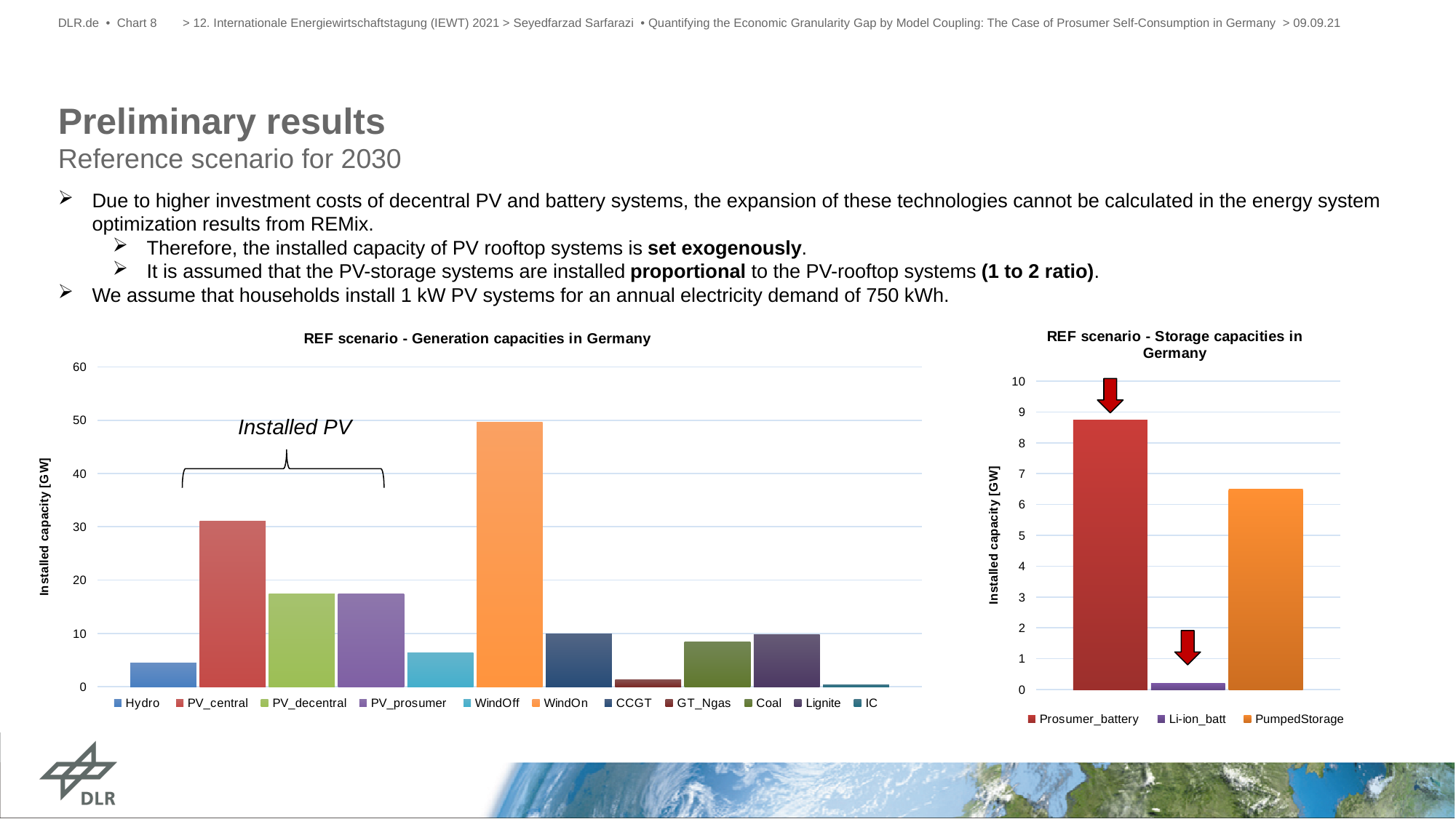
In the 'REF scenario - Storage capacities in Germany' chart, which category has the lowest installed capacity? Li-ion_batt In the 'REF scenario - Storage capacities in Germany' chart, which category has the highest installed capacity? Prosumer_battery What is the y-axis label of the 'REF scenario - Storage capacities in Germany' chart? Installed capacity [GW] How many series does the legend of the 'REF scenario - Storage capacities in Germany' chart list? 3 What kind of chart is the 'REF scenario - Generation capacities in Germany' chart? bar chart In the 'REF scenario - Generation capacities in Germany' chart, is the value for PV_central greater or less than 20? greater In the 'REF scenario - Generation capacities in Germany' chart, which category has the lowest installed capacity? IC In the 'REF scenario - Generation capacities in Germany' chart, is the value for WindOn greater or less than 40? greater In the 'REF scenario - Generation capacities in Germany' chart, which is larger, Hydro or WindOff? WindOff In the 'REF scenario - Generation capacities in Germany' chart, which category has the highest installed capacity? WindOn How many series does the legend of the 'REF scenario - Generation capacities in Germany' chart list? 11 In the 'REF scenario - Storage capacities in Germany' chart, is the value for PumpedStorage greater or less than 5? greater